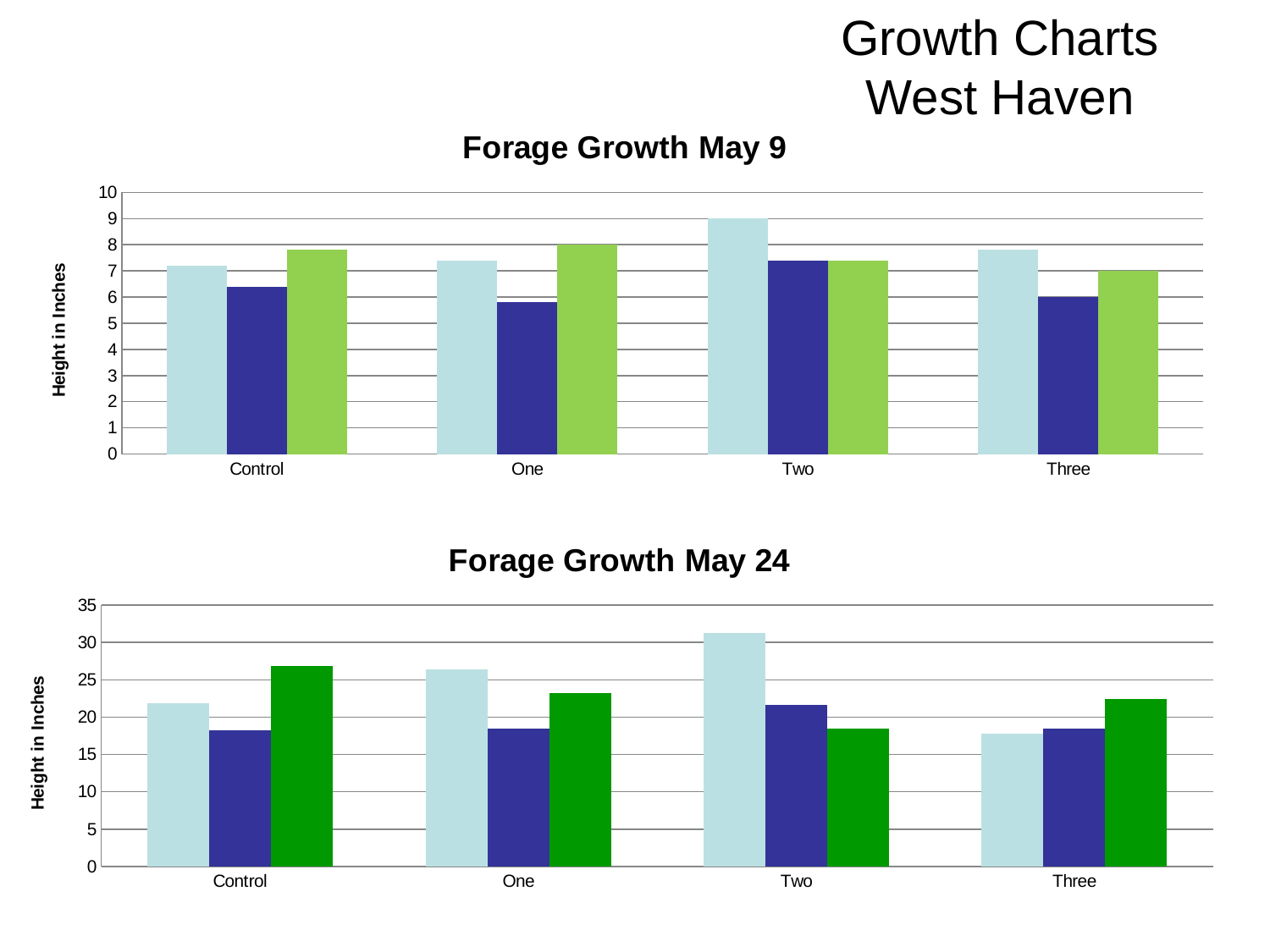
In the 'Forage Growth May 9' chart, for Two, which is larger: the light blue bar or the dark blue bar? the light blue bar In the 'Forage Growth May 24' chart, which category has the lowest light blue bar? Three In the 'Forage Growth May 24' chart, is the light blue bar for Two greater or less than 30? greater In the 'Forage Growth May 9' chart, which category has the tallest light blue bar? Two In the 'Forage Growth May 24' chart, is the light blue bar for Three greater or less than 20? less What is the y-axis title of the 'Forage Growth May 24' chart? Height in Inches In the 'Forage Growth May 9' chart, what is the value of the green bar for One? 8 In the 'Forage Growth May 9' chart, what is the value of the light blue bar for Two? 9 In the 'Forage Growth May 9' chart, what is the value of the dark blue bar for Three? 6 What kind of chart is the 'Forage Growth May 9' chart? bar chart How many categories are shown on the x axis of the 'Forage Growth May 24' chart? 4 In the 'Forage Growth May 24' chart, for Control, which is larger: the green bar or the light blue bar? the green bar